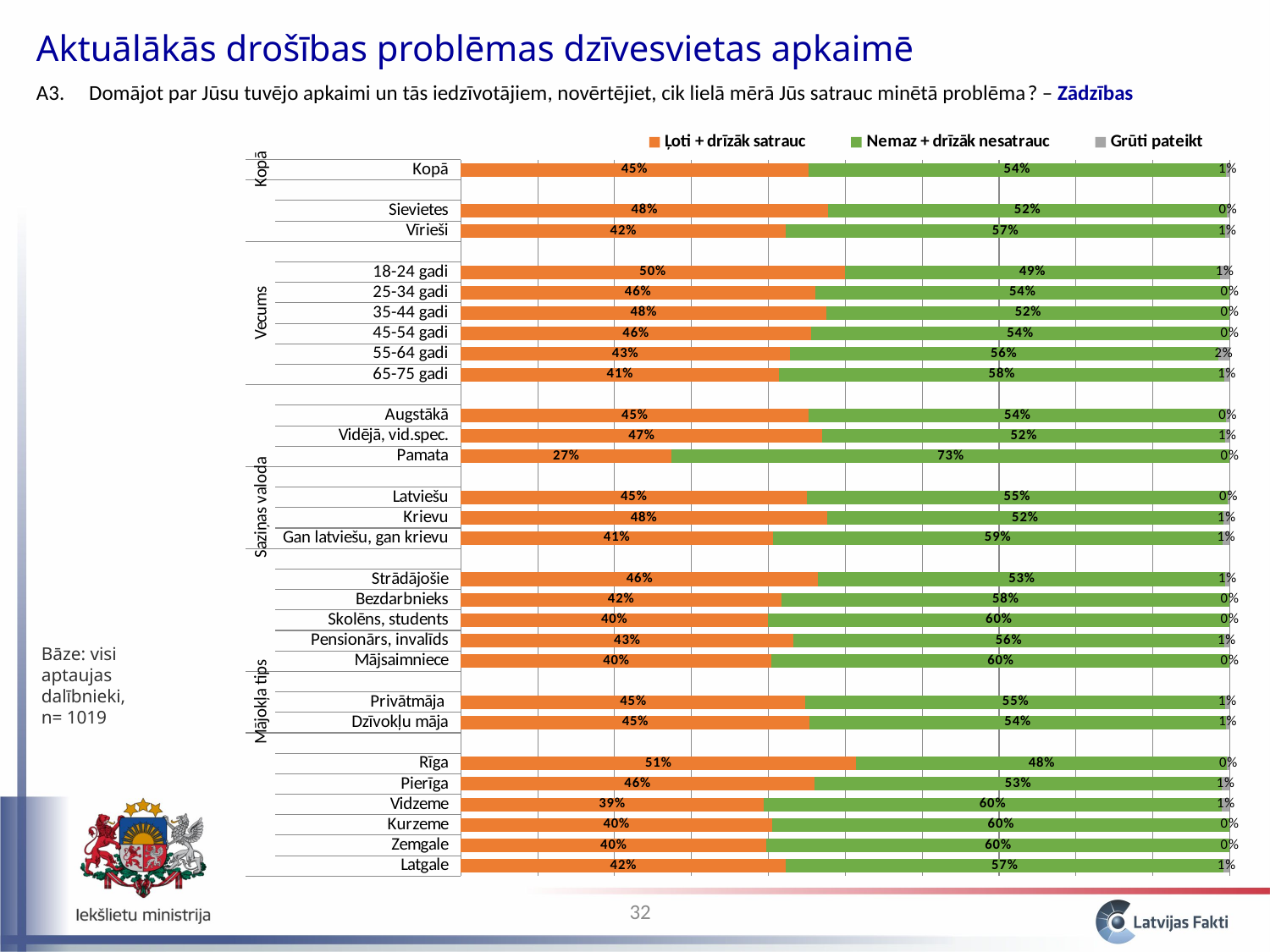
Which colour represents the "Nemaz + drīzāk nesatrauc" series? Green What is the value of "Ļoti + drīzāk satrauc" for Kopā? 45% What is the value of "Grūti pateikt" for 55-64 gadi? 2% Which category has the lowest value for "Ļoti + drīzāk satrauc"? Pamata What kind of chart is shown on the slide? Stacked bar chart What is the total of the stacked bar for 18-24 gadi? 100% How many series does the legend list? 3 What is the value of "Nemaz + drīzāk nesatrauc" for Pamata? 73% Which category has the highest value for "Ļoti + drīzāk satrauc"? Rīga Which has a larger "Nemaz + drīzāk nesatrauc" value, Latviešu or Krievu? Latviešu What is the difference between the "Ļoti + drīzāk satrauc" values for Sievietes and Vīrieši? 6% How many categories are plotted in the chart? 28